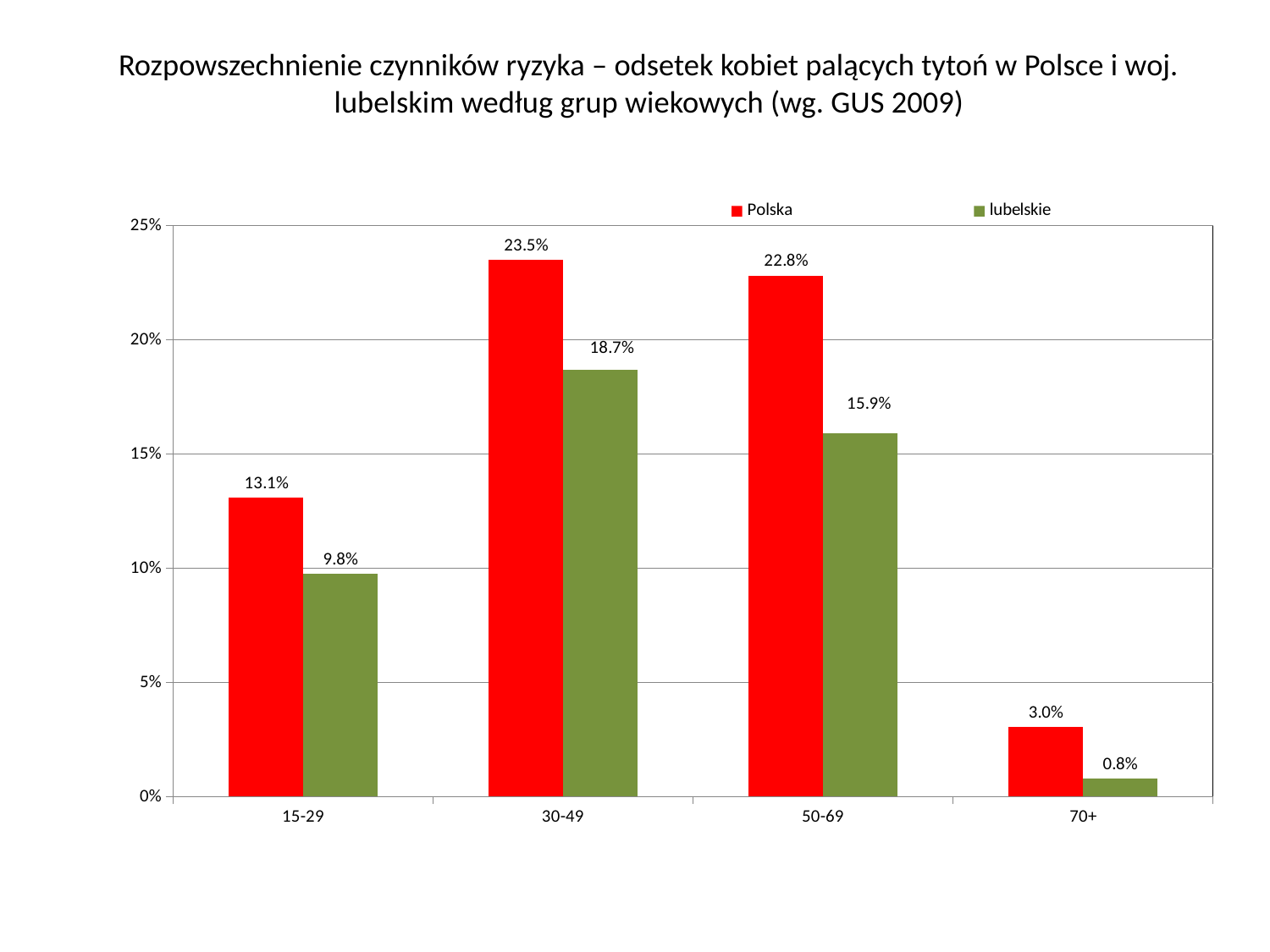
Is the value for lubelskie in the 30-49 age group greater or less than 15%? greater Which is larger in the 50-69 age group, Polska or lubelskie? Polska What is the value for Polska in the 30-49 age group? 23.5% What is the value for lubelskie in the 70+ age group? 0.8% What kind of chart is shown on the slide? bar chart How many series does the legend list? 2 Which age group has the highest value for Polska? 30-49 What is the value for lubelskie in the 50-69 age group? 15.9% Which colour represents the Polska series? red What is the difference between Polska and lubelskie in the 15-29 age group? 3.3% Which age group has the lowest value for lubelskie? 70+ How many age groups are shown on the x axis? 4